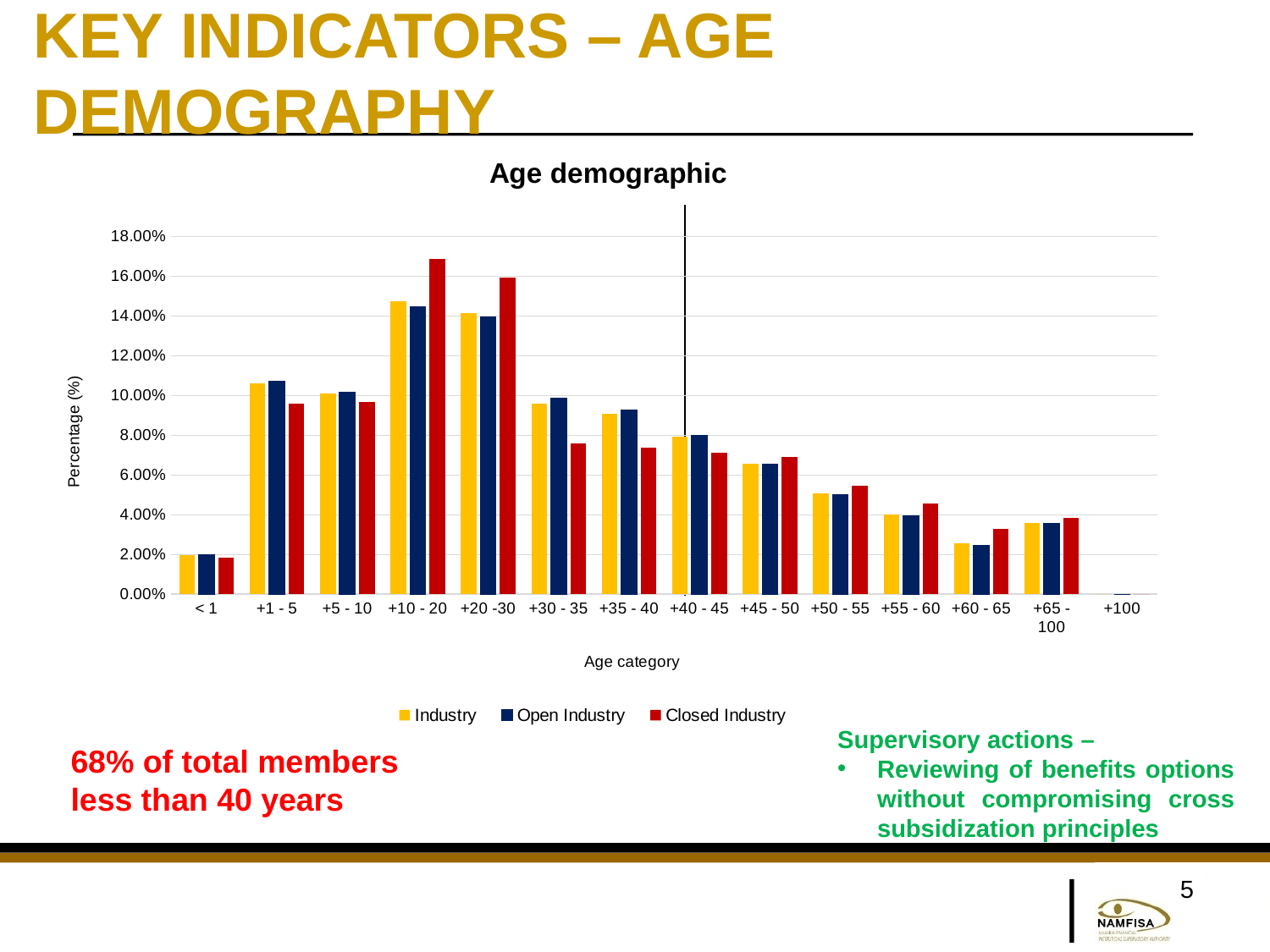
Is the Industry value for +50 - 55 greater or less than 4.00%? greater What is the title of the y axis? Percentage (%) For the +30 - 35 age category, which is larger: Open Industry or Closed Industry? Open Industry How many age categories are shown on the x axis? 14 Do the values generally rise or fall from the +10 - 20 category to the +100 category? Fall How many series does the legend list? 3 Is the Closed Industry value for +10 - 20 greater or less than 16.00%? greater Which age category has the highest value for Industry? +10 - 20 What type of chart is shown on the slide? Bar chart Which age category has the lowest value for Industry? +100 Which age category has the highest value for Closed Industry? +10 - 20 Is the Closed Industry value for +30 - 35 greater or less than 8.00%? less